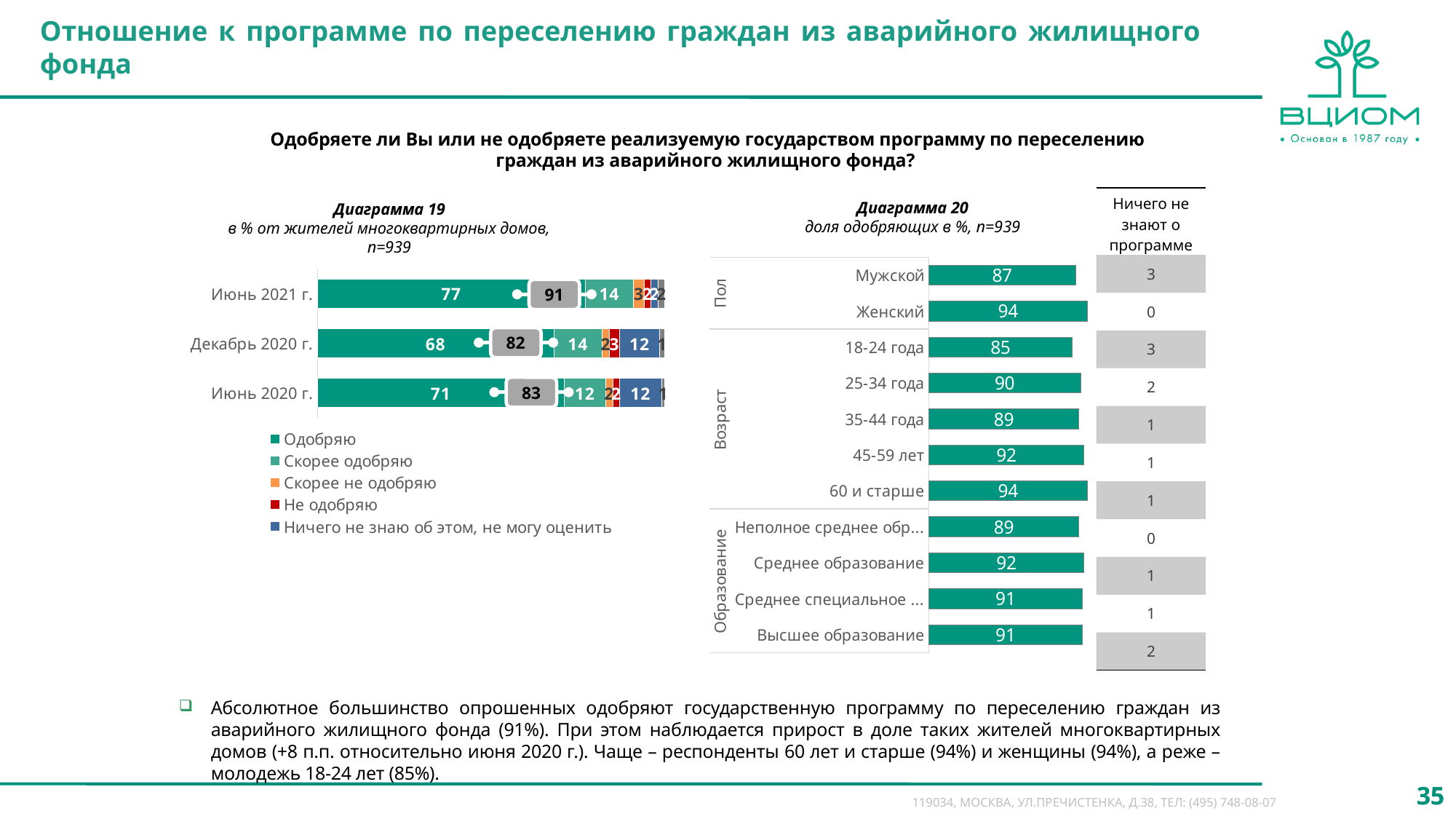
What type of chart is Диаграмма 20? Bar chart In Диаграмма 19, how many series does the legend list? 5 In Диаграмма 20, what is the difference between the values for Женский and Мужской? 7 In Диаграмма 20, which is larger: the value for 45-59 лет or for 35-44 года? 45-59 лет In Диаграмма 20, how many categories are plotted? 11 In Диаграмма 19, what is the value for "Скорее одобряю" for Июнь 2020 г.? 12 In Диаграмма 19, what is the value for "Одобряю" for Июнь 2021 г.? 77 In Диаграмма 19, what is the combined approval value shown in the grey box for Декабрь 2020 г.? 82 In Диаграмма 19, what is the difference between the "Одобряю" values for Июнь 2021 г. and Декабрь 2020 г.? 9 In Диаграмма 20, which age group has the lowest share of approving respondents? 18-24 года In Диаграмма 20, what is the share of approving respondents among Мужской? 87 In Диаграмма 19, which period has the highest "Одобряю" value? Июнь 2021 г.